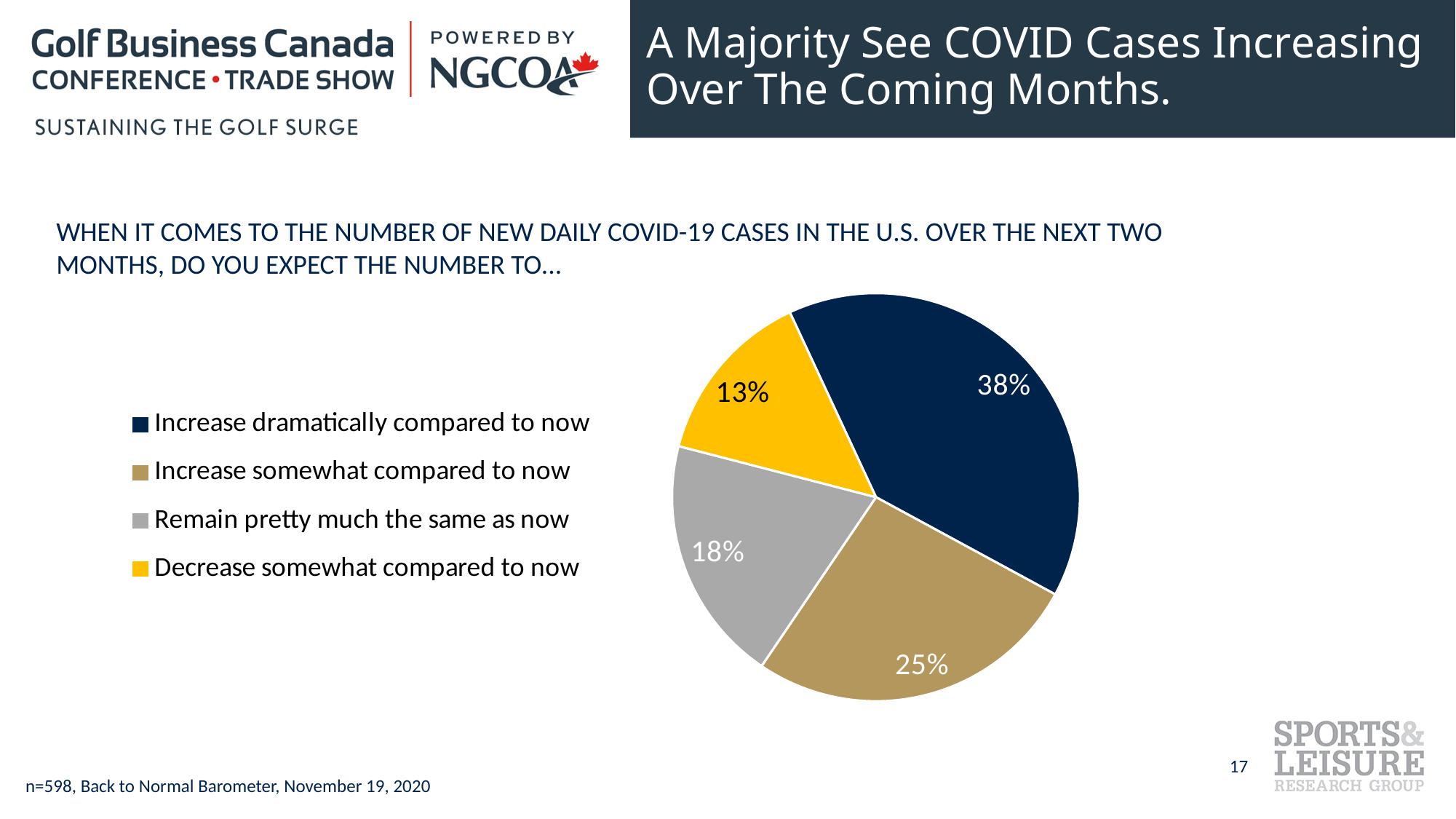
What percentage of respondents expect COVID-19 cases to decrease somewhat compared to now? 13% Which response has the largest share of the pie? Increase dramatically compared to now Which is larger: the share for 'Increase somewhat compared to now' or 'Remain pretty much the same as now'? Increase somewhat compared to now Which response has the smallest share of the pie? Decrease somewhat compared to now What type of chart is shown on the slide? Pie chart Which colour represents 'Decrease somewhat compared to now' in the pie chart? Yellow What is the combined percentage of respondents who expect cases to increase (dramatically or somewhat)? 63% What is the difference in percentage points between 'Increase dramatically compared to now' and 'Decrease somewhat compared to now'? 25 What percentage of respondents expect COVID-19 cases to remain pretty much the same as now? 18% What percentage of respondents expect COVID-19 cases to increase somewhat compared to now? 25% What percentage of respondents expect COVID-19 cases to increase dramatically compared to now? 38% How many categories are shown in the pie chart? 4